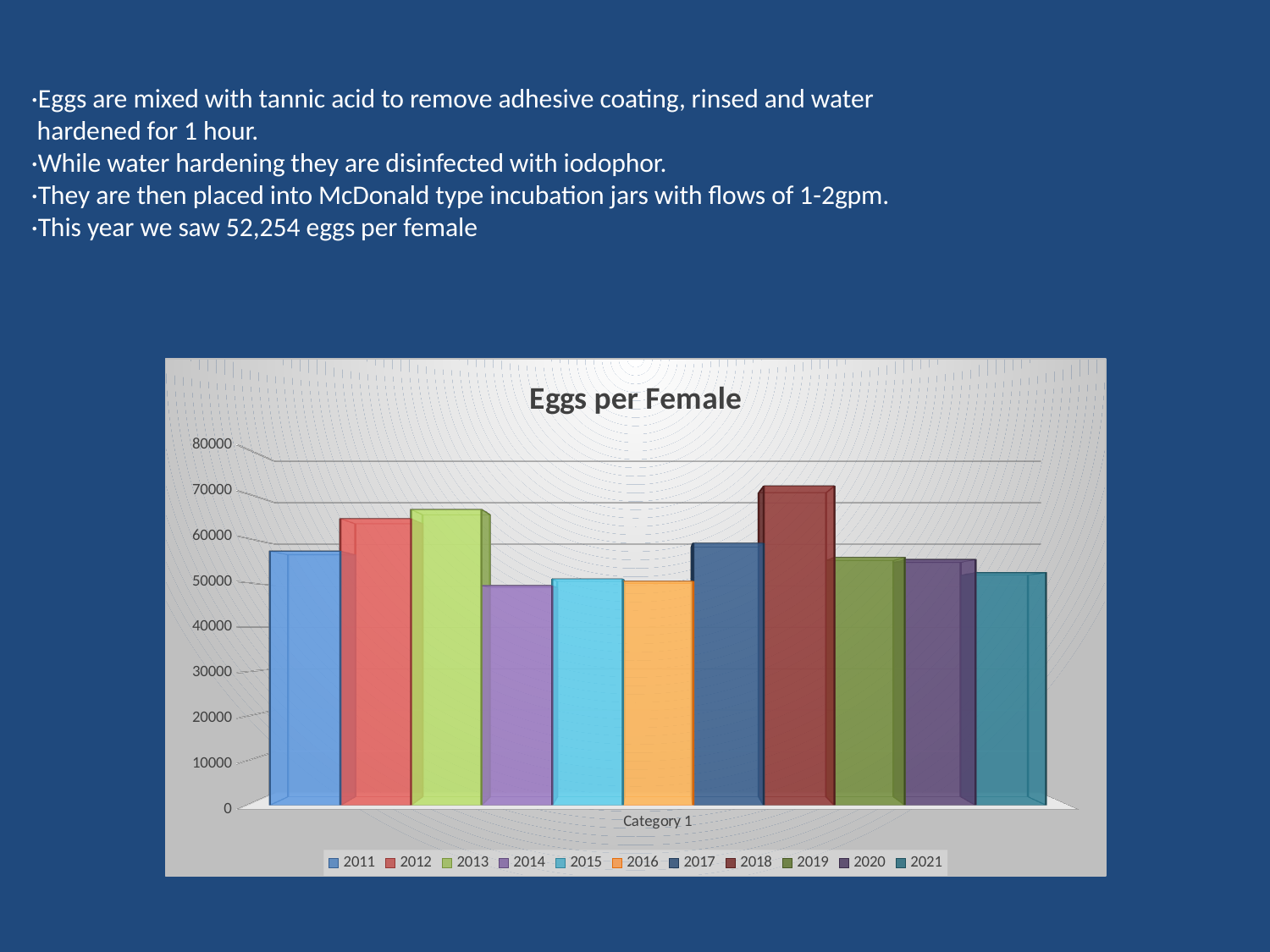
Which is larger, the value for 2013 or the value for 2014? 2013 Which is larger, the value for 2012 or the value for 2017? 2012 Is the value for 2013 greater or less than 60000? greater What is the title of the chart? Eggs per Female Is the value for 2018 greater or less than 60000? greater Is the value for 2011 greater or less than 60000? less Which year has the highest eggs per female value? 2018 What kind of chart is shown on the slide? bar chart How many series does the chart legend list? 11 What is the label of the single category on the x axis? Category 1